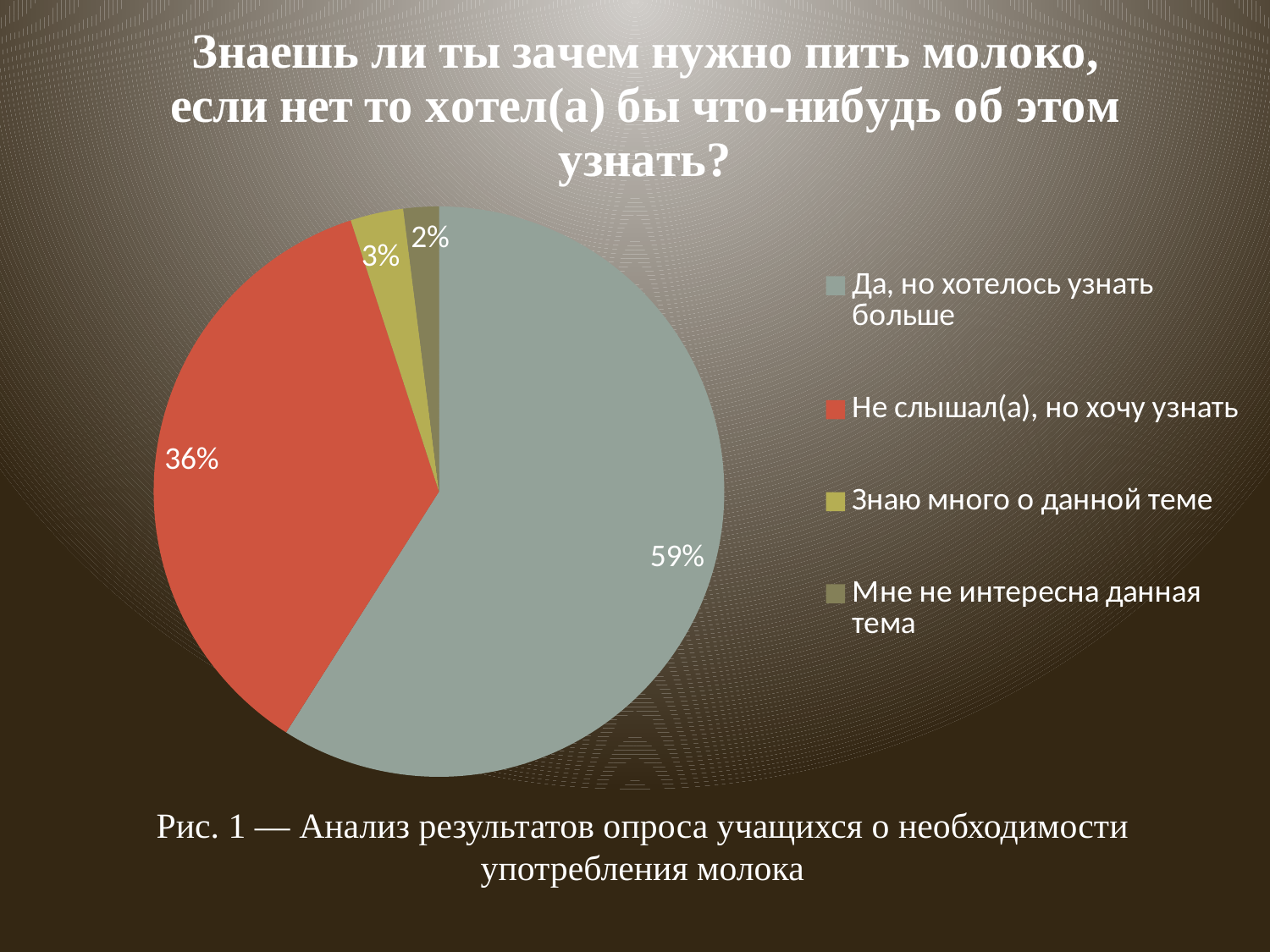
What type of chart is shown on the slide? Pie chart Which response has the smallest share of the pie? Мне не интересна данная тема What percentage of respondents answered "Да, но хотелось узнать больше"? 59% How many entries does the legend list? 4 Which is larger: the share for "Знаю много о данной теме" or for "Мне не интересна данная тема"? Знаю много о данной теме How many slices does the pie chart have? 4 What percentage of respondents answered "Знаю много о данной теме"? 3% What percentage of respondents answered "Мне не интересна данная тема"? 2% Which response has the largest share of the pie? Да, но хотелось узнать больше What is the difference in percentage points between "Да, но хотелось узнать больше" and "Не слышал(а), но хочу узнать"? 23 What percentage of respondents answered "Не слышал(а), но хочу узнать"? 36% What colour is the slice for "Не слышал(а), но хочу узнать"? Red